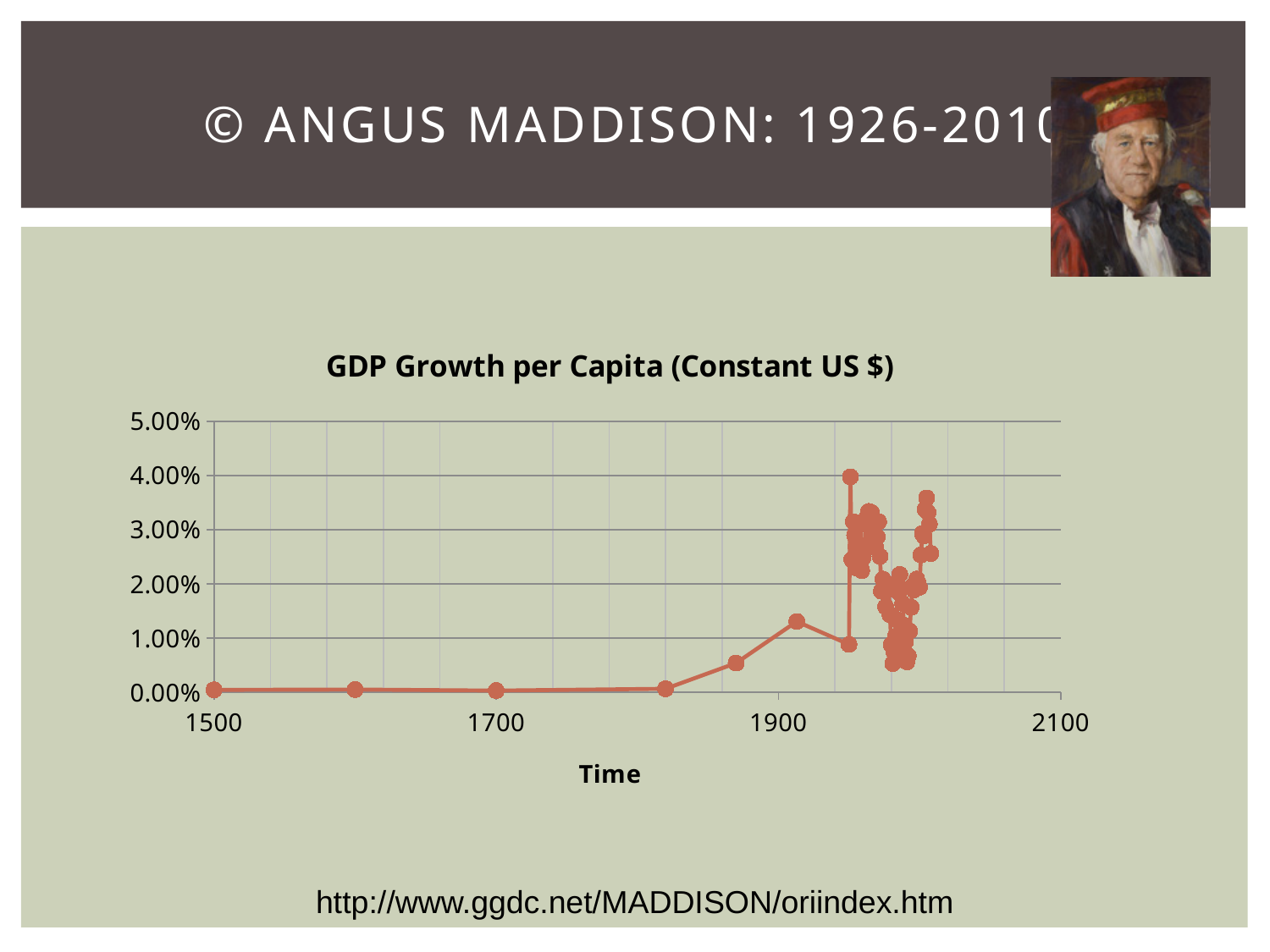
What kind of chart is shown on the slide? line chart Does the highest value on the chart occur before or after 1900? after Is the value plotted at 1500 greater or less than 1.00%? less Is the highest point on the chart greater or less than 3.00%? greater Which is larger, the value plotted at 1700 or the value plotted just after 1900? the value just after 1900 Is the value plotted at 1700 greater or less than 1.00%? less What is the title of the chart? GDP Growth per Capita (Constant US $) Do the plotted values generally rise or fall between 1500 and 1900? rise What is the label on the x axis of the chart? Time